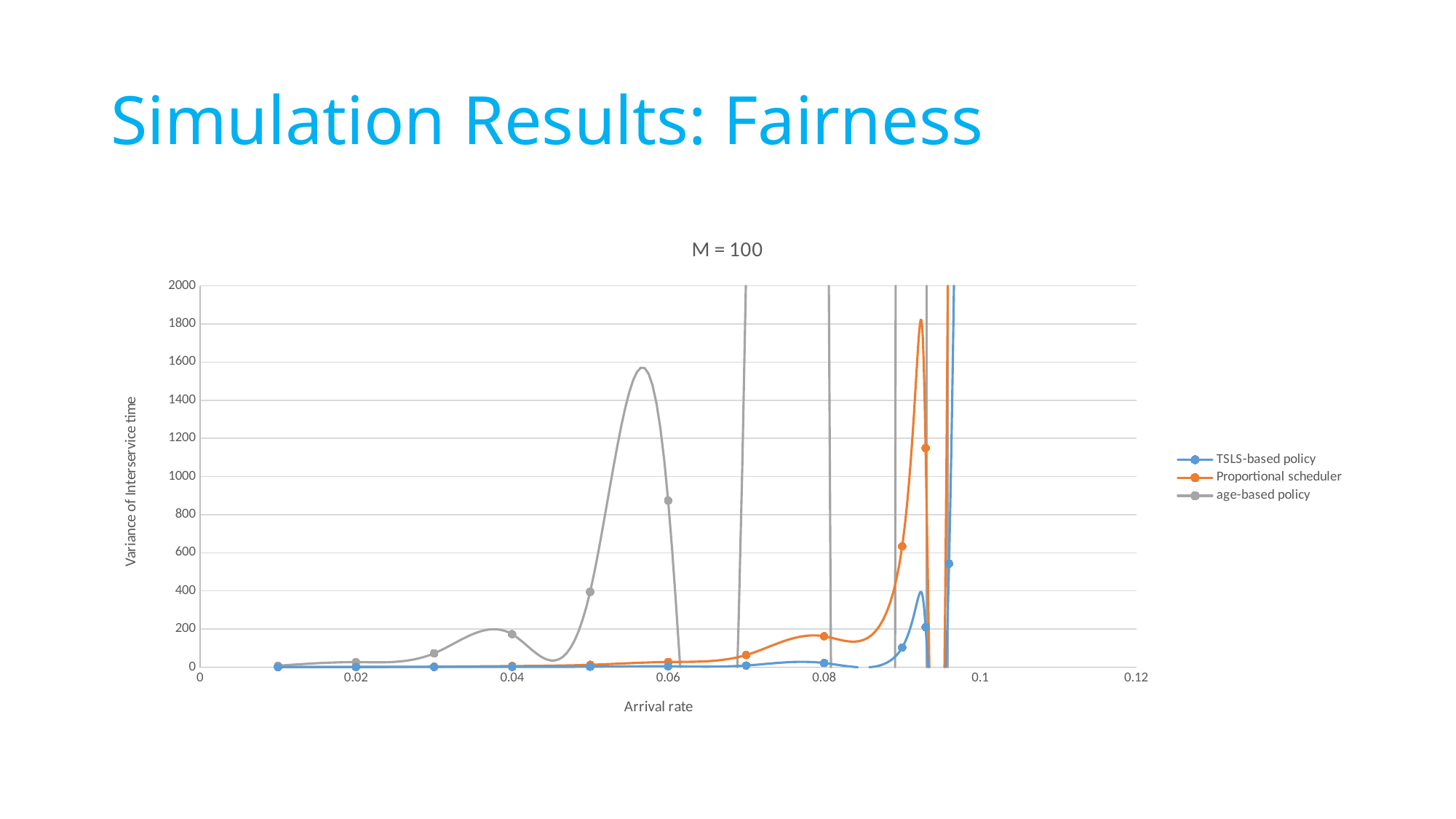
What is the title of the chart? M = 100 Is the value for the age-based policy at an arrival rate of 0.05 greater or less than 600? less Is the value for the age-based policy at an arrival rate of 0.06 greater or less than 600? greater Is the value for the TSLS-based policy at an arrival rate of 0.09 greater or less than 200? less At an arrival rate of 0.06, which series has the larger value: the age-based policy or the Proportional scheduler? age-based policy Does the Proportional scheduler series generally rise or fall as the arrival rate increases from 0.01 to 0.094? rise At an arrival rate of 0.09, which series has the larger value: the Proportional scheduler or the TSLS-based policy? Proportional scheduler What type of chart is shown on the slide? line chart At an arrival rate of 0.08, which series has the larger value: the Proportional scheduler or the TSLS-based policy? Proportional scheduler How many series does the legend list? 3 What is the label of the vertical axis? Variance of Interservice time